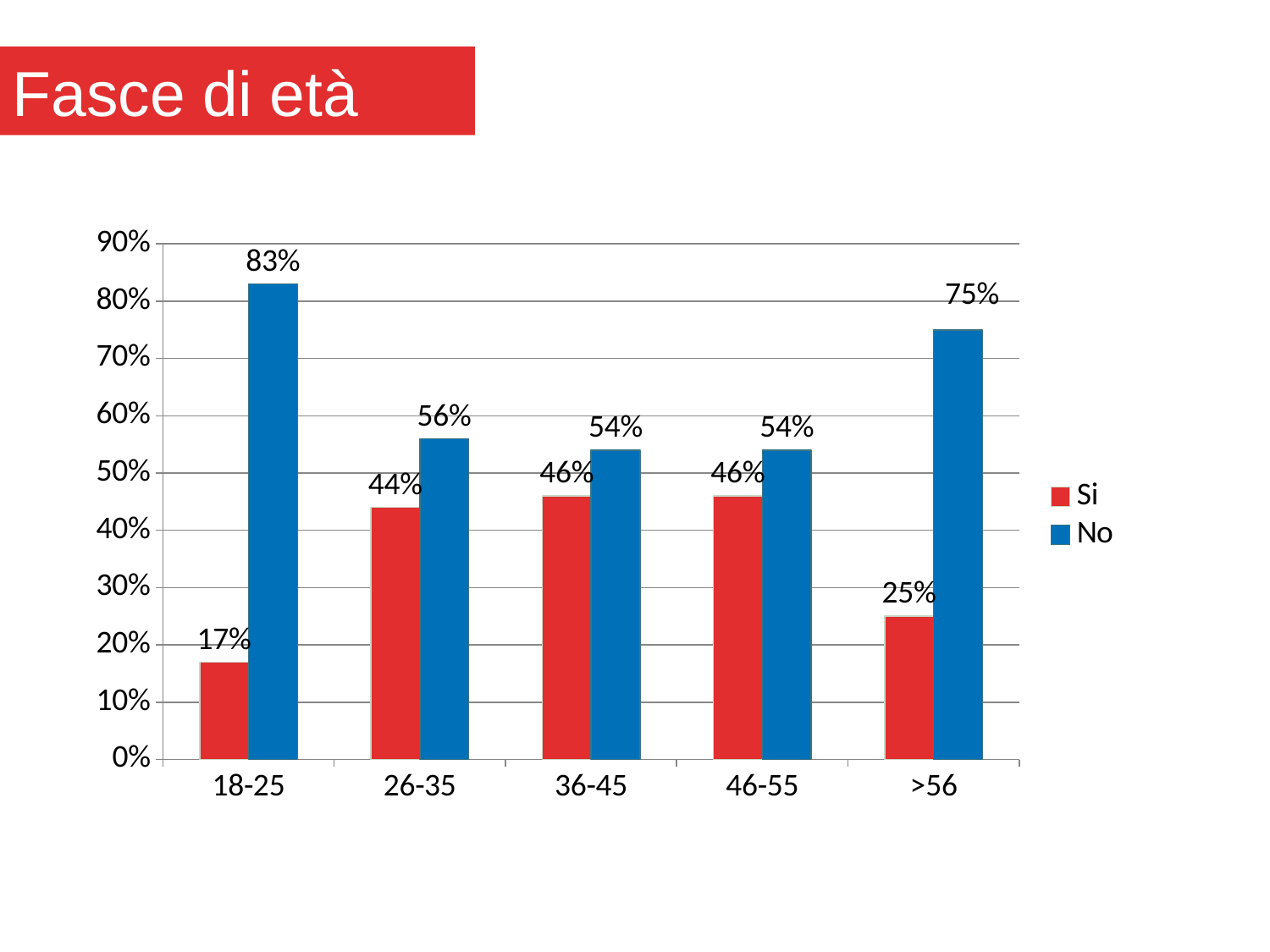
What kind of chart is shown on the slide? bar chart Which age group has the highest No value? 18-25 What is the value of the No series for the >56 age group? 75% Is the Si value for the >56 age group greater or less than 30%? less How many series does the legend list? 2 What is the title of the slide? Fasce di età How many age groups are shown on the x axis? 5 Which is larger for the 36-45 age group, the Si value or the No value? No What is the difference between the No and Si values for the 18-25 age group? 66% What is the value of the Si series for the 26-35 age group? 44% Which age group has the lowest Si value? 18-25 What is the value of the Si series for the 18-25 age group? 17%